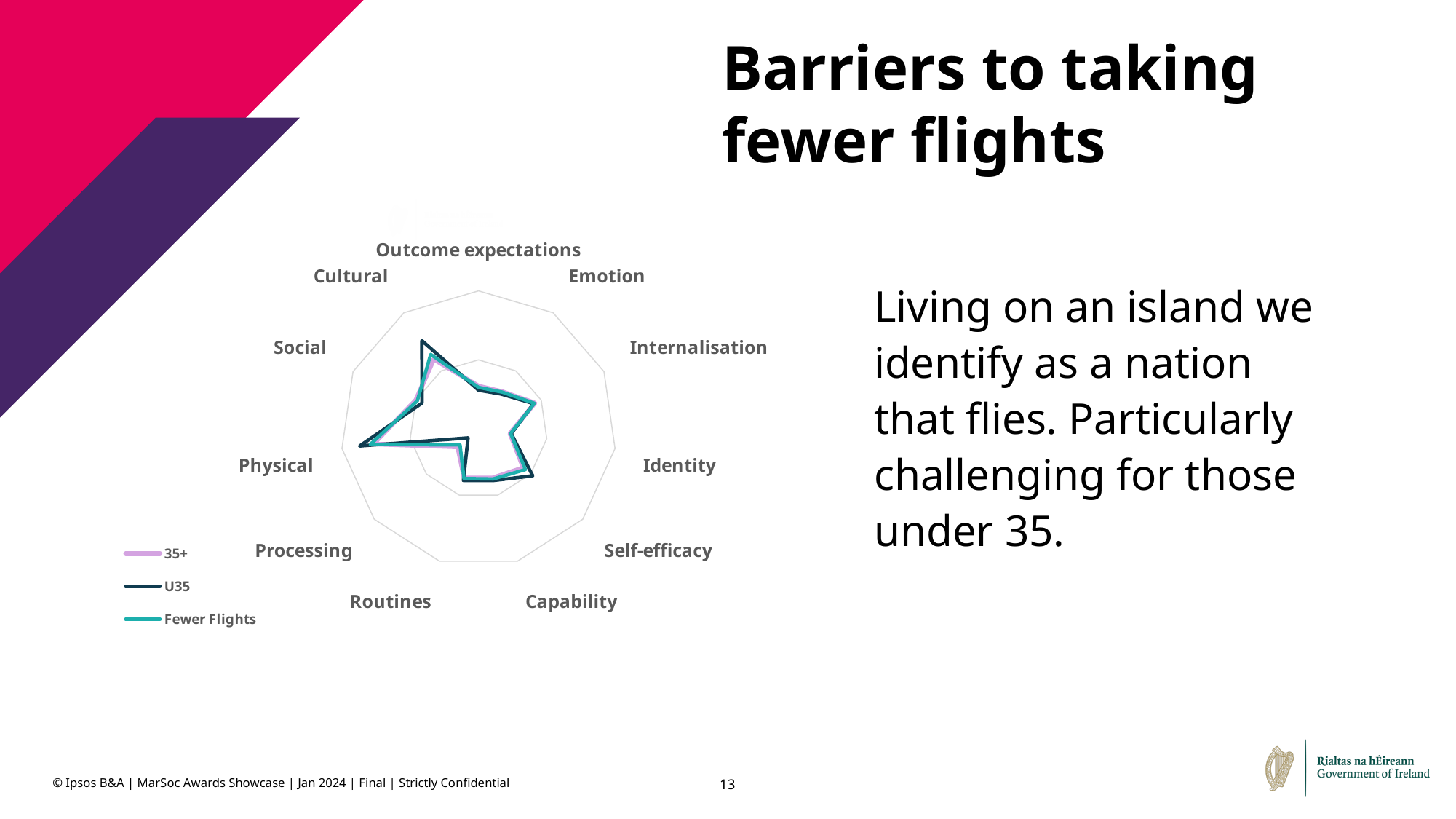
How many series does the chart's legend list? 3 For the U35 series, which is larger: the value for Physical or the value for Emotion? Physical What are the three series listed in the chart's legend? 35+, U35, Fewer Flights For the U35 series, which is larger: the value for Cultural or the value for Internalisation? Cultural Which category has the highest value for the U35 series? Physical For the 35+ series, which is larger: the value for Physical or the value for Identity? Physical What kind of chart is shown on the slide? Radar chart How many categories (axes) does the radar chart have? 11 Which category has the highest value for the Fewer Flights series? Physical Which series in the legend is drawn in dark navy? U35